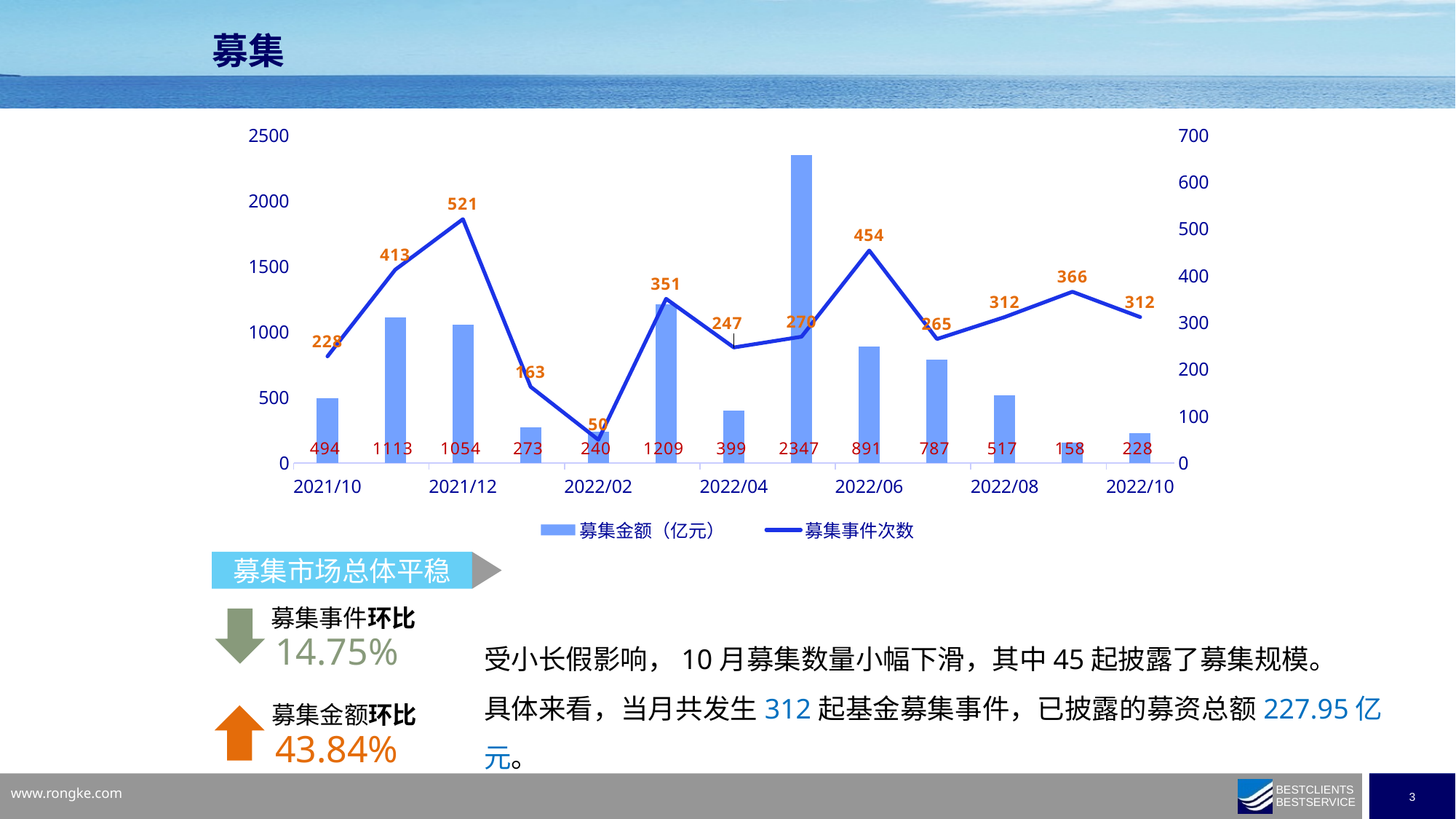
What is the 募集金额（亿元） value for 2022/10? 228 How many series does the legend list? 2 What is the 募集金额（亿元） value for 2021/12? 1054 In which month does 募集事件次数 reach its lowest value? 2022/02 What is the 募集事件次数 value for 2022/06? 454 In which month does 募集事件次数 reach its highest value? 2021/12 How many months are plotted along the x axis? 13 What is the difference in 募集事件次数 between 2021/12 and 2022/02? 471 Does 募集事件次数 rise or fall from 2021/10 to 2021/12? Rise Which month has the larger 募集金额（亿元）, 2022/04 or 2022/08? 2022/08 What type of chart is shown on the slide? Combination bar and line chart What is the highest 募集金额（亿元） value shown in the chart? 2347